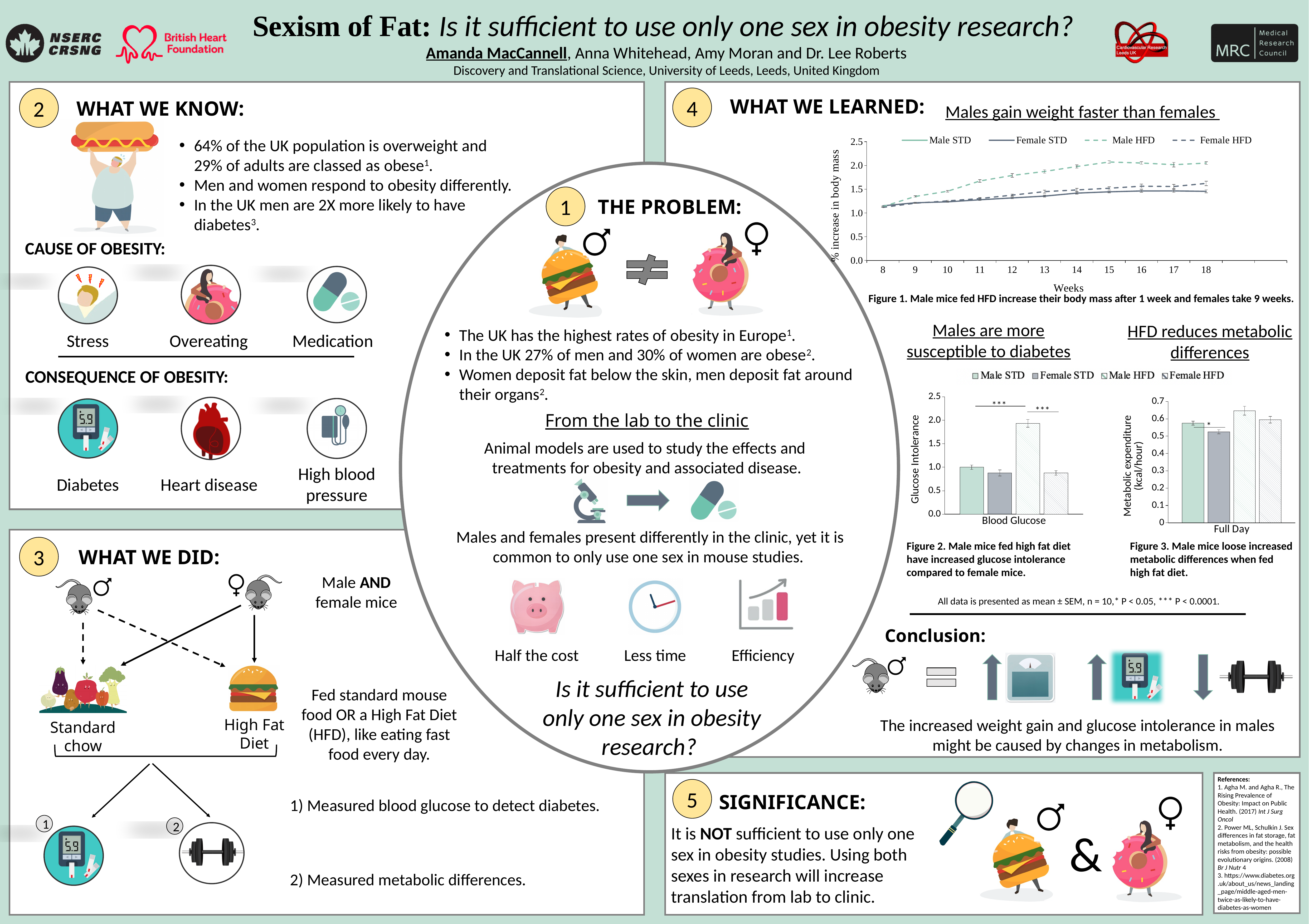
In the 'Males gain weight faster than females' chart (Figure 1), which series has the highest % increase in body mass at week 18? Male HFD In the 'Males gain weight faster than females' chart (Figure 1), does the Male HFD series rise or fall from week 8 to week 18? rise What kind of chart is the 'Males are more susceptible to diabetes' chart (Figure 2)? bar chart In the 'Males are more susceptible to diabetes' chart (Figure 2), is the glucose intolerance for Male HFD greater or less than 1.5? greater In the 'HFD reduces metabolic differences' chart (Figure 3), is the metabolic expenditure for Male HFD greater or less than 0.6? greater In the 'Males are more susceptible to diabetes' chart (Figure 2), which group has the highest glucose intolerance? Male HFD In the 'Males gain weight faster than females' chart (Figure 1), is the Male HFD value at week 18 greater or less than 1.5? greater In the 'HFD reduces metabolic differences' chart (Figure 3), which group has the lowest metabolic expenditure? Female STD What kind of chart is the 'Males gain weight faster than females' chart (Figure 1)? line chart In the 'HFD reduces metabolic differences' chart (Figure 3), which is larger: the metabolic expenditure for Male STD or Female STD? Male STD In the 'Males gain weight faster than females' chart (Figure 1), how many weeks are shown on the x axis? 11 How many series does the legend of the 'Males gain weight faster than females' chart (Figure 1) list? 4